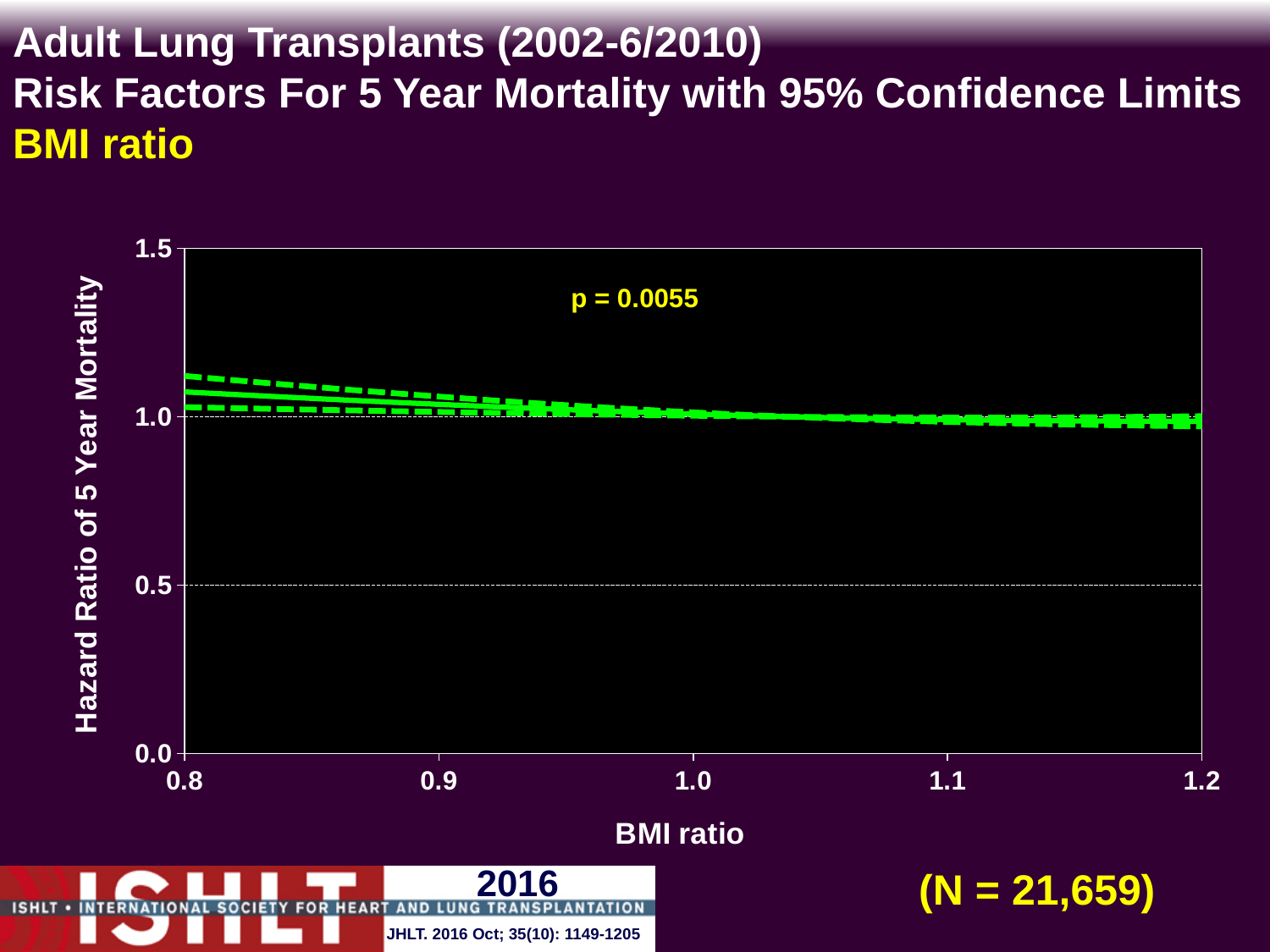
At which end of the BMI ratio axis, 0.8 or 1.2, is the hazard ratio of 5 year mortality highest? 0.8 Is the hazard ratio of 5 year mortality at a BMI ratio of 0.8 greater or less than 1.0? greater What kind of chart is shown on the slide? line chart Is the hazard ratio of 5 year mortality at a BMI ratio of 0.8 greater or less than 1.5? less What is the sample size N shown on the slide? 21,659 Is the hazard ratio of 5 year mortality at a BMI ratio of 1.0 greater or less than 0.5? greater Which BMI ratio has the larger hazard ratio of 5 year mortality, 0.8 or 1.2? 0.8 What p-value is printed on the chart? p = 0.0055 Does the hazard ratio of 5 year mortality rise or fall as BMI ratio increases from 0.8 to 1.2? fall